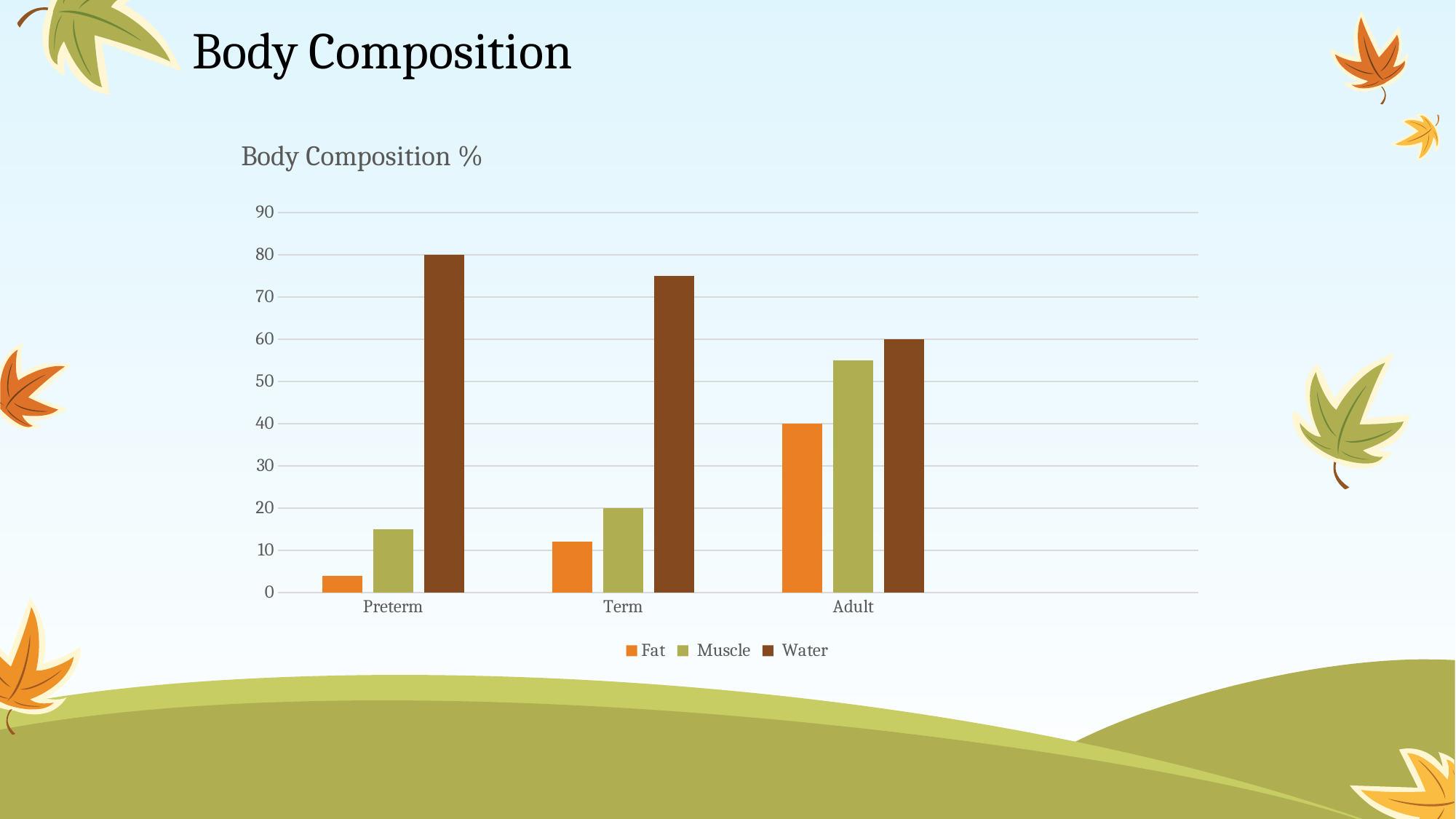
Does the Fat value rise or fall from Preterm to Adult? rise Which category has the lowest Fat value? Preterm What is the Fat value for Adult? 40 What is the Water value for Adult? 60 How many categories are shown on the x axis? 3 How many series does the legend list? 3 What type of chart is shown on the slide? bar chart What is the Muscle value for Term? 20 Which category has the highest Water value? Preterm What is the Water value for Preterm? 80 What is the title of the chart? Body Composition % Is the Water value for Term greater or less than 70? greater